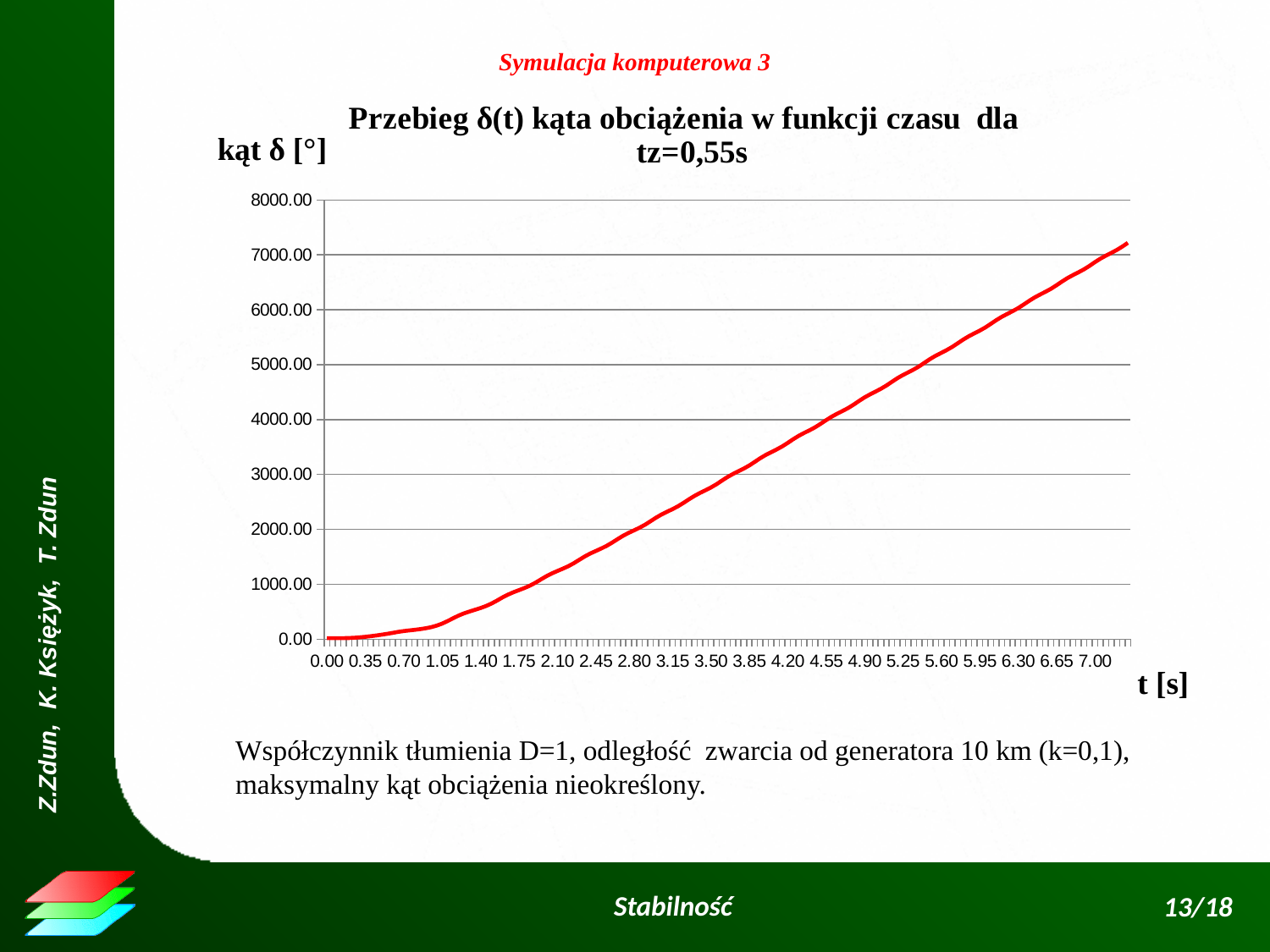
At which time t is the plotted line at its lowest value? 0.00 Which is larger: the value of the line at t = 2.10 or at t = 4.90? t = 4.90 What colour is the plotted line? red Does the plotted angle δ(t) rise or fall as time t increases? rise What is the highest tick value shown on the vertical axis? 8000.00 Is the value of the line at t = 0.70 greater or less than 1000.00? less What kind of chart is shown on the slide? line chart Is the value of the line at t = 3.50 greater or less than 3000.00? less